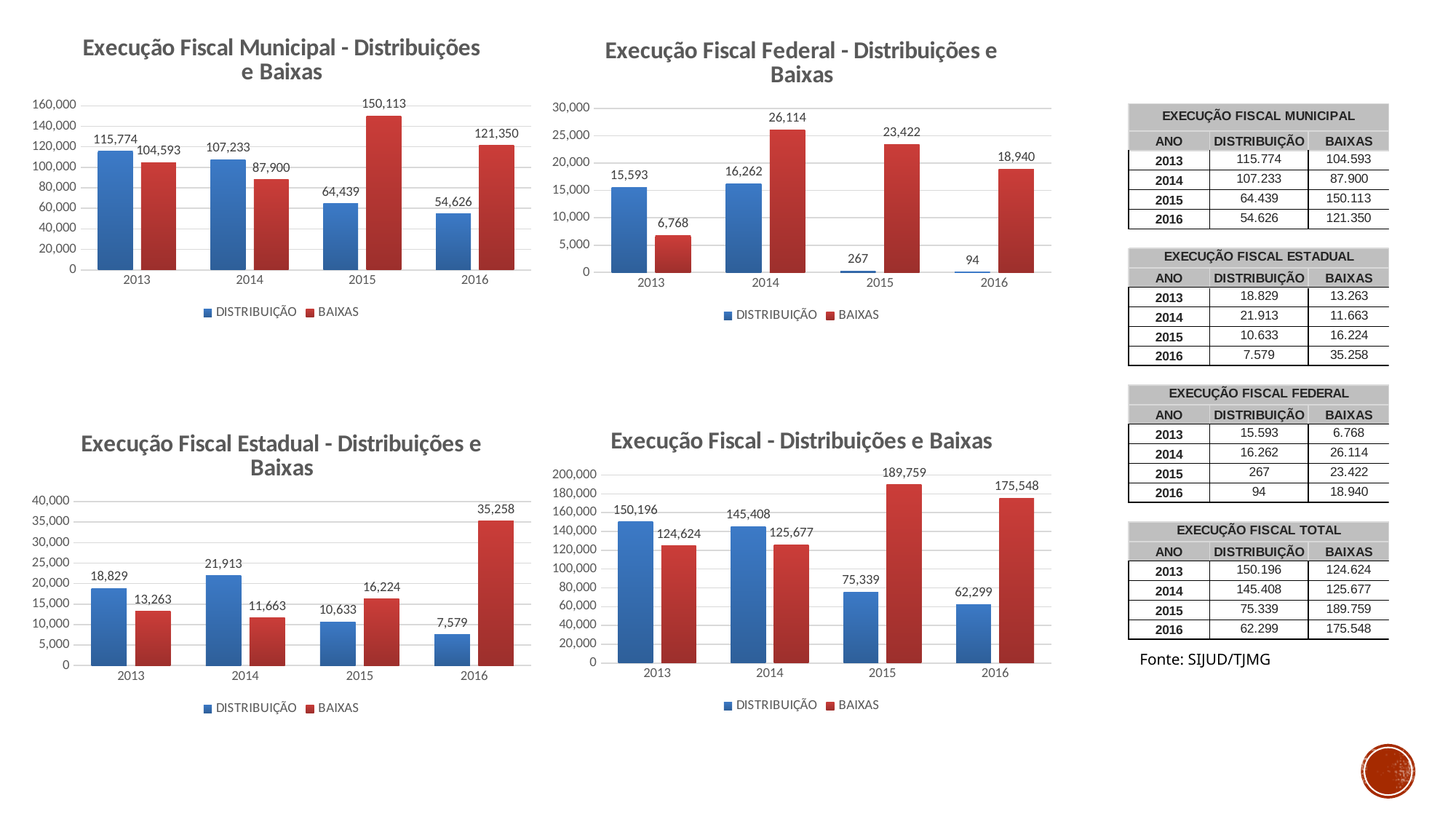
In the 'Execução Fiscal Federal - Distribuições e Baixas' chart, which year has the lowest BAIXAS value? 2013 In the 'Execução Fiscal Estadual - Distribuições e Baixas' chart, which is larger in 2014, DISTRIBUIÇÃO or BAIXAS? DISTRIBUIÇÃO In the 'Execução Fiscal Estadual - Distribuições e Baixas' chart, does the DISTRIBUIÇÃO value rise or fall from 2014 to 2016? fall In the 'Execução Fiscal Federal - Distribuições e Baixas' chart, what is the difference between BAIXAS and DISTRIBUIÇÃO in 2014? 9,852 In the 'Execução Fiscal Estadual - Distribuições e Baixas' chart, what is the BAIXAS value for 2016? 35,258 What kind of chart is 'Execução Fiscal - Distribuições e Baixas'? bar chart In the 'Execução Fiscal - Distribuições e Baixas' chart, what is the BAIXAS value for 2015? 189,759 In the 'Execução Fiscal - Distribuições e Baixas' chart, how many series does the legend list? 2 In the 'Execução Fiscal Municipal - Distribuições e Baixas' chart, which year has the highest BAIXAS value? 2015 In the 'Execução Fiscal Federal - Distribuições e Baixas' chart, what is the DISTRIBUIÇÃO value for 2016? 94 In the 'Execução Fiscal Municipal - Distribuições e Baixas' chart, what is the difference between BAIXAS and DISTRIBUIÇÃO in 2015? 85,674 In the 'Execução Fiscal Municipal - Distribuições e Baixas' chart, what is the DISTRIBUIÇÃO value for 2013? 115,774